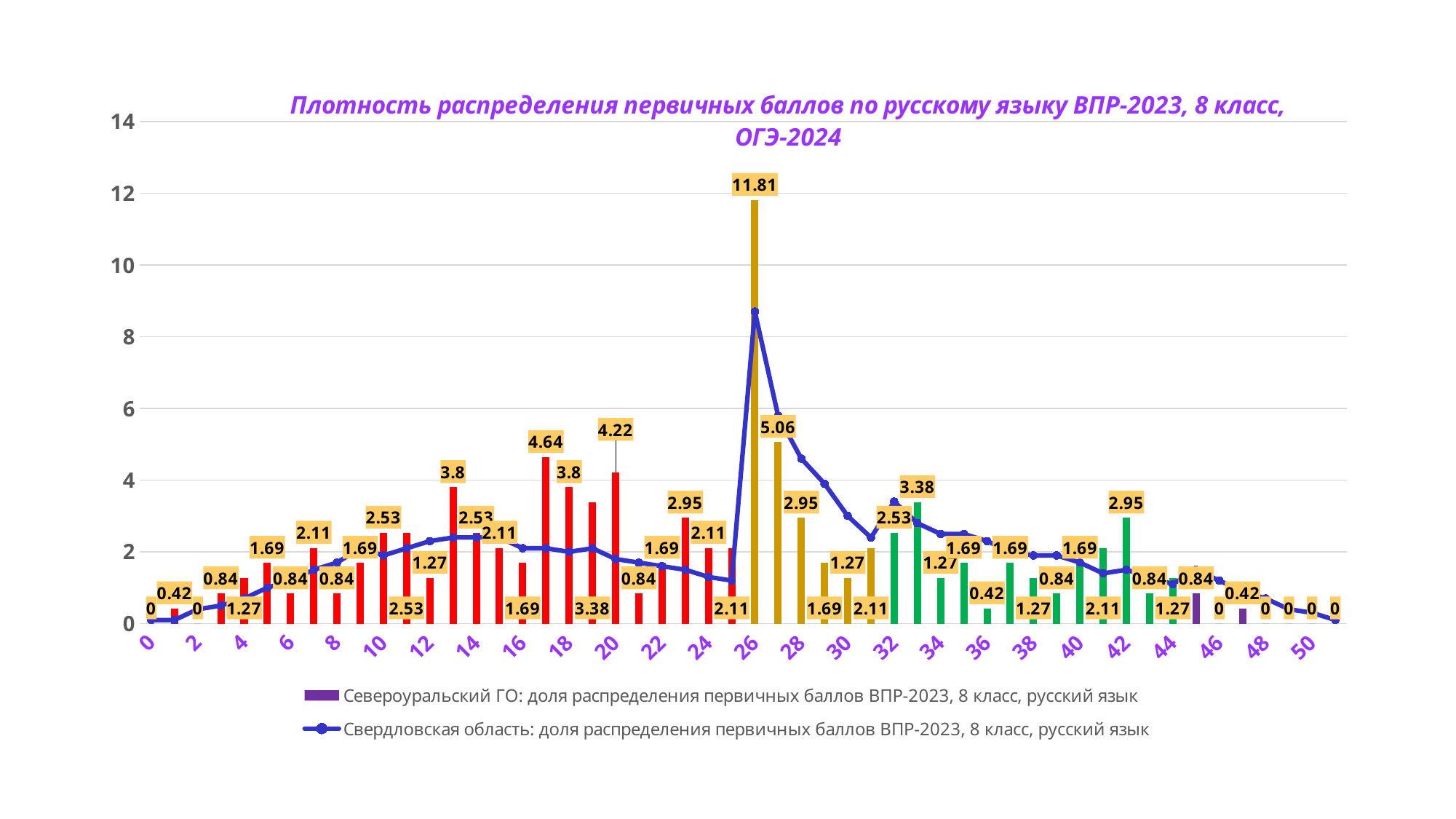
What is the Североуральский ГО value at score 42? 2.95 What is the difference between the Североуральский ГО values at scores 26 and 27? 6.75 What kind of chart is used to plot the Североуральский ГО series? bar chart What is the Североуральский ГО value at score 27? 5.06 How many series does the legend list? 2 At which score does the Североуральский ГО series reach its highest value? 26 What is the Североуральский ГО value at score 17? 4.64 Which region does the line series in the legend represent? Свердловская область Is the Свердловская область line value at score 28 greater or less than 4? greater Which score has the larger Североуральский ГО value, 17 or 20? 17 What is the Североуральский ГО value at score 26? 11.81 Do the Североуральский ГО values rise or fall from score 26 to score 30? fall